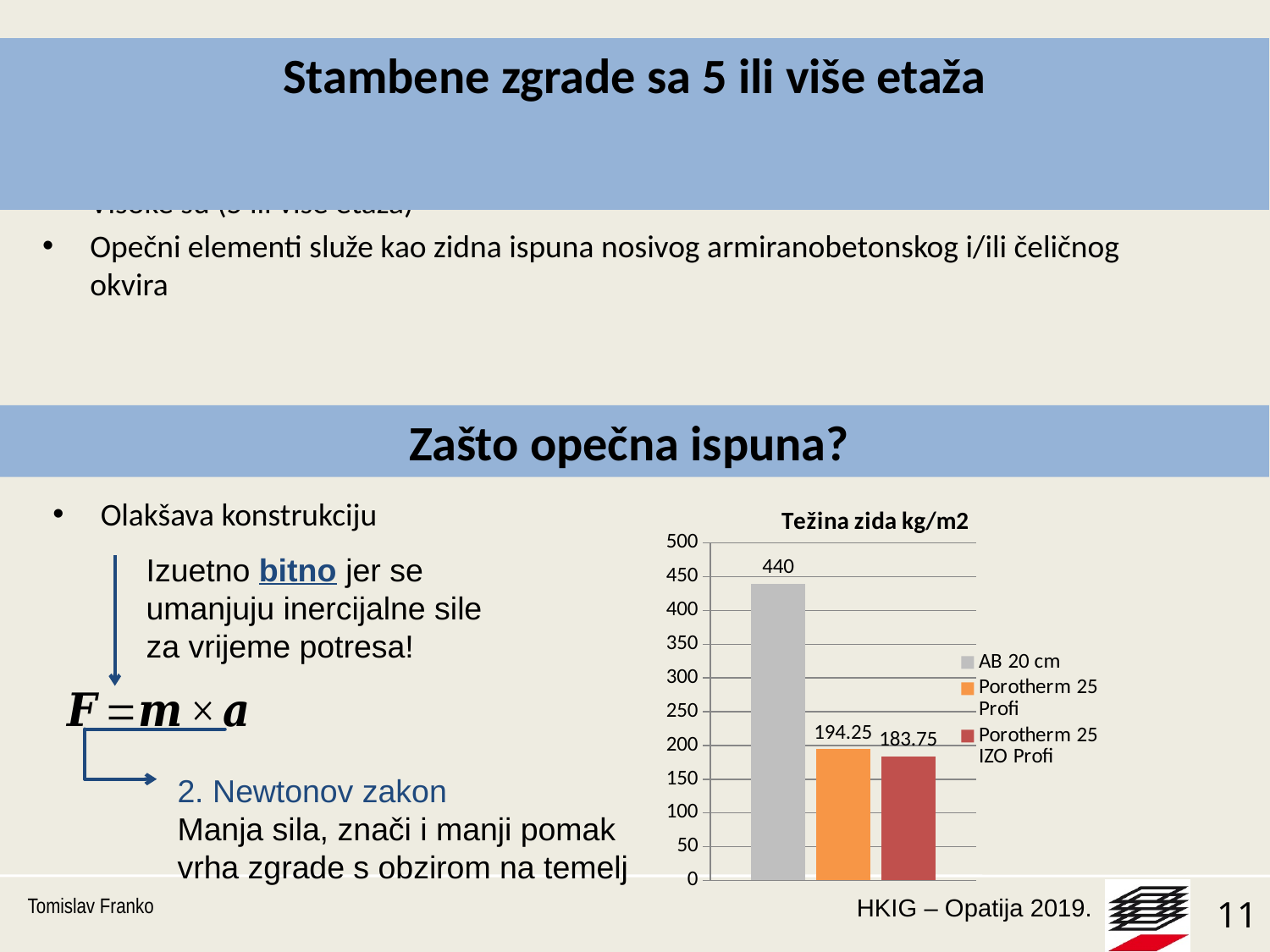
What is the difference between the values for Porotherm 25 Profi and Porotherm 25 IZO Profi? 10.5 What is the value for Porotherm 25 IZO Profi in the chart? 183.75 Which is larger, the value for AB 20 cm or the value for Porotherm 25 IZO Profi? AB 20 cm Which series has the highest value in the chart? AB 20 cm Which series has the lowest value in the chart? Porotherm 25 IZO Profi What is the difference between the values for AB 20 cm and Porotherm 25 Profi? 245.75 What is the value for Porotherm 25 Profi in the chart? 194.25 What is the value for AB 20 cm in the chart? 440 What is the title of the chart? Težina zida kg/m2 What kind of chart is shown on the slide? bar chart How many series does the chart legend list? 3 Is the value for AB 20 cm greater or less than 400? greater